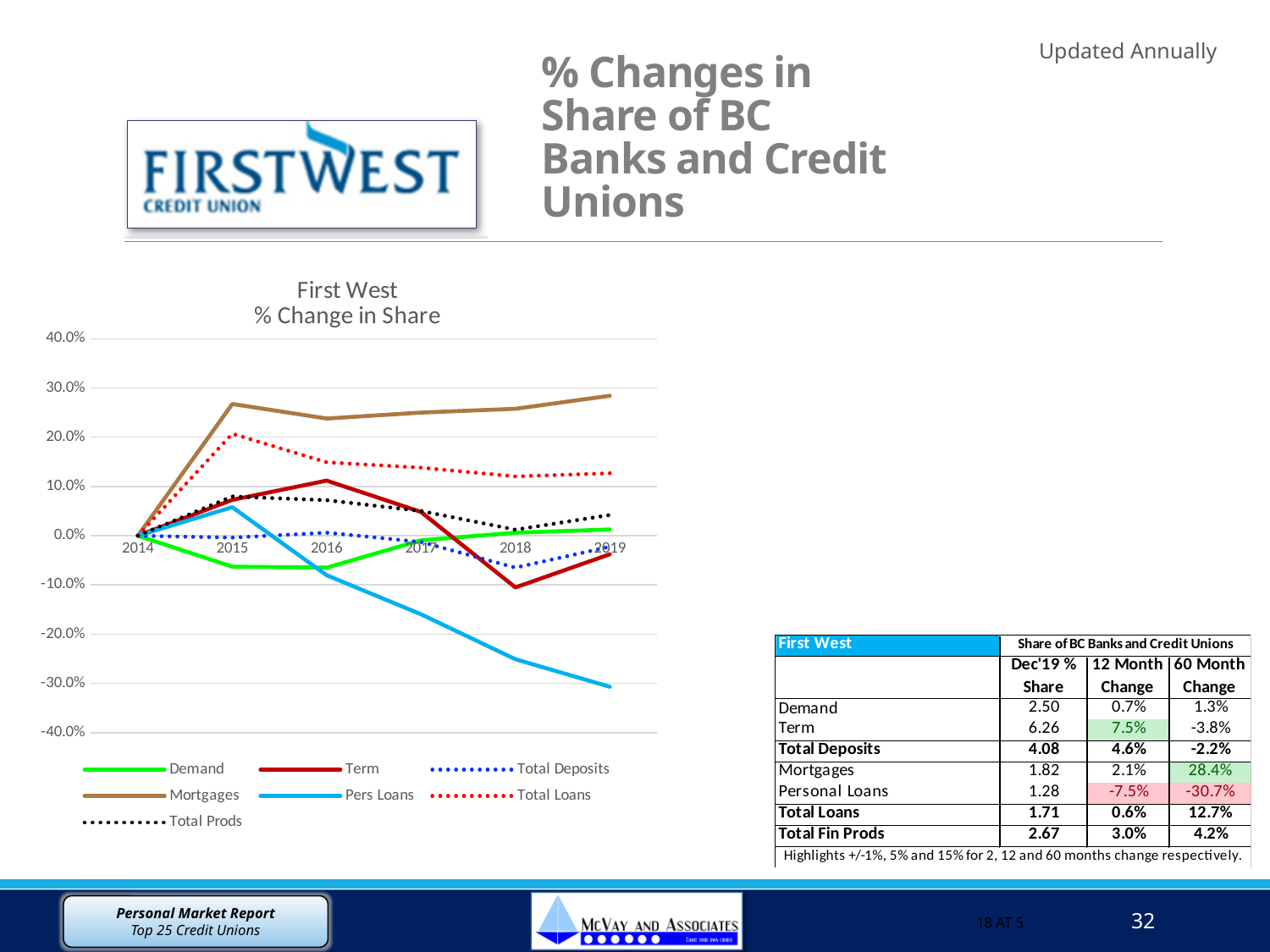
What is the title of the chart? First West % Change in Share Is the value for Mortgages in 2019 greater or less than 20.0%? greater Is the value for Pers Loans in 2019 greater or less than -20.0%? less Does the Mortgages line rise or fall from 2014 to 2015? rise Which series has the lowest value in 2019? Pers Loans Does the Pers Loans line rise or fall from 2015 to 2019? fall What kind of chart is shown on the slide? line chart How many years are shown along the x axis of the chart? 6 Which series has the highest value in 2019? Mortgages Is the value for Term in 2018 greater or less than 0.0%? less How many series does the chart legend list? 7 In 2015, which is larger: the value for Mortgages or the value for Term? Mortgages